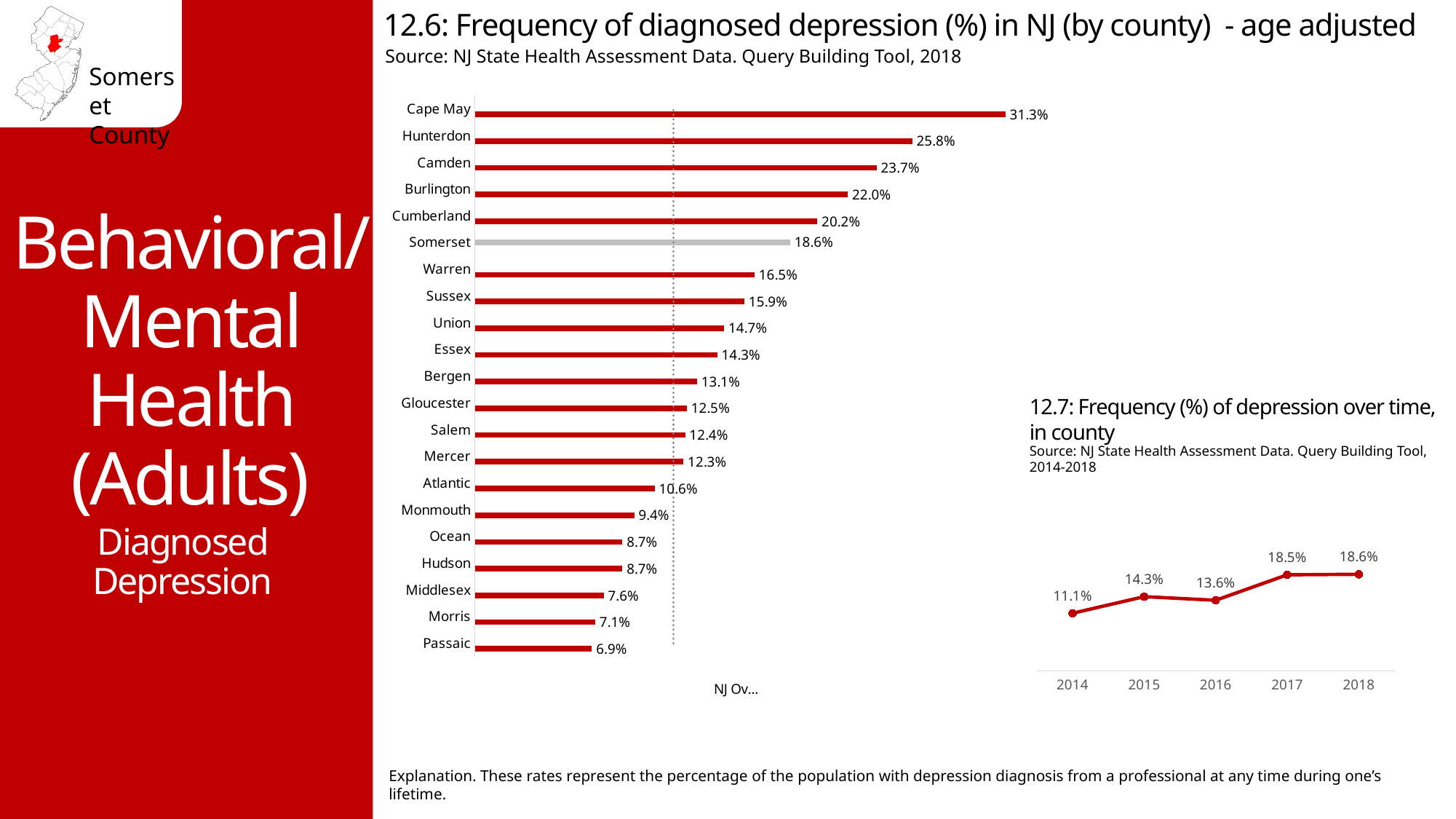
In chart 12.6 (Frequency of diagnosed depression by county), what is the value for Atlantic? 10.6% In chart 12.6 (Frequency of diagnosed depression by county), which is larger, Camden or Burlington? Camden In chart 12.7 (Frequency of depression over time, in county), what is the difference between 2018 and 2014? 7.5% What kind of chart is chart 12.7 (Frequency of depression over time, in county)? Line chart In chart 12.6 (Frequency of diagnosed depression by county), what is the value for Somerset? 18.6% In chart 12.6 (Frequency of diagnosed depression by county), what is the difference between Cape May and Hunterdon? 5.5% In chart 12.7 (Frequency of depression over time, in county), which year has the highest value? 2018 In chart 12.7 (Frequency of depression over time, in county), what is the value for 2016? 13.6% In chart 12.6 (Frequency of diagnosed depression by county), how many counties are plotted? 21 In chart 12.6 (Frequency of diagnosed depression by county), which county has the highest value? Cape May In chart 12.6 (Frequency of diagnosed depression by county), which county has the lowest value? Passaic What kind of chart is chart 12.6 (Frequency of diagnosed depression by county)? Bar chart